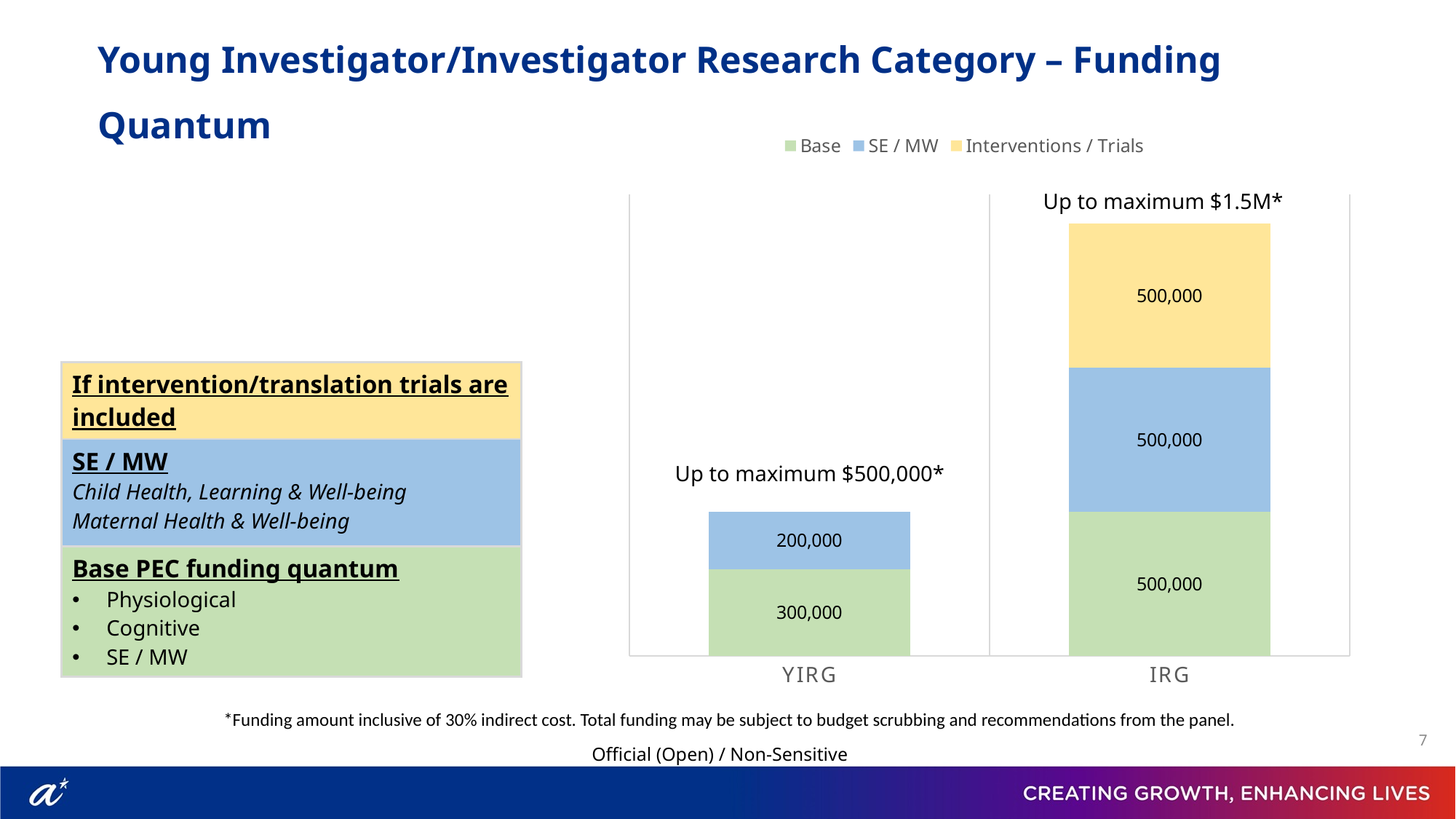
How many series does the legend list? 3 What is the Interventions / Trials value for IRG? 500,000 Which category has the larger SE / MW value, YIRG or IRG? IRG How many categories are shown on the x axis? 2 What is the Base value for IRG? 500,000 What is the total of the stacked bar for IRG? 1,500,000 What is the SE / MW value for YIRG? 200,000 What is the total of the stacked bar for YIRG? 500,000 What is the Base value for YIRG? 300,000 Which series is shown in yellow in the legend? Interventions / Trials What kind of chart is shown? Stacked bar chart What is the difference between the Base values for IRG and YIRG? 200,000